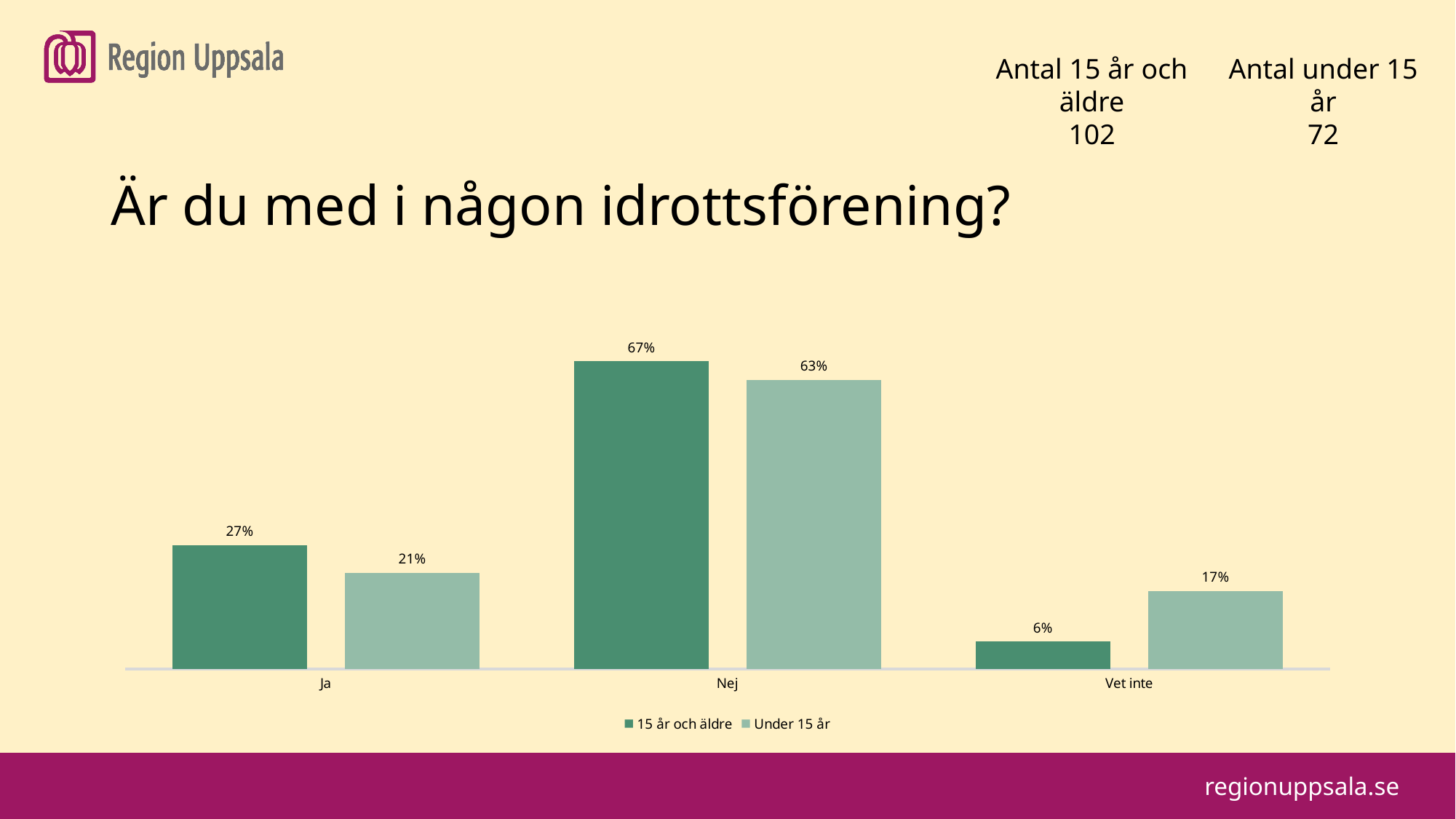
What is the title of the slide? Är du med i någon idrottsförening? What is the value for "Vet inte" in the "15 år och äldre" series? 6% What is the value for "Ja" in the "Under 15 år" series? 21% Which category has the highest value in the "Under 15 år" series? Nej Which category has the lowest value in the "15 år och äldre" series? Vet inte How many categories are shown on the x axis? 3 What is the value for "Nej" in the "15 år och äldre" series? 67% What is the difference between the "15 år och äldre" and "Under 15 år" values for "Nej"? 4 percentage points What kind of chart is shown on the slide? Bar chart For "Vet inte", which series has the larger value: "15 år och äldre" or "Under 15 år"? Under 15 år What is the difference between the "15 år och äldre" and "Under 15 år" values for "Ja"? 6 percentage points How many series does the legend list? 2